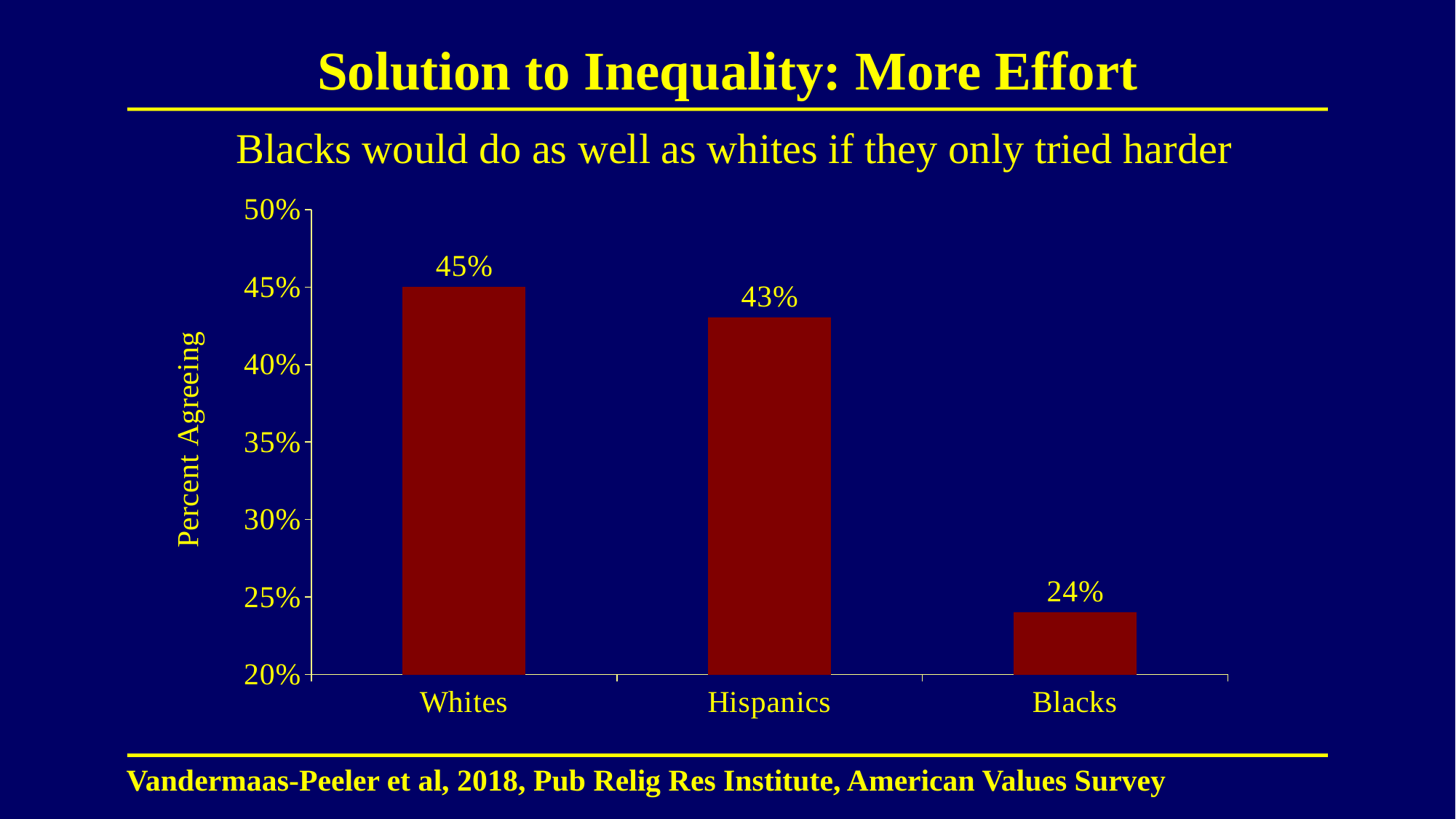
What is the difference in percent agreeing between Whites and Blacks? 21% What percent of Whites agree that Blacks would do as well as whites if they only tried harder? 45% What is the label on the vertical axis? Percent Agreeing What is the value shown for Hispanics? 43% Which group has the highest percent agreeing? Whites How many groups are shown on the x axis? 3 What is the difference in percent agreeing between Hispanics and Blacks? 19% What is the value shown for Blacks? 24% What kind of chart is shown on the slide? Bar chart Which group has the lowest percent agreeing? Blacks Which group has a larger percent agreeing, Hispanics or Blacks? Hispanics Is the value for Blacks greater or less than 30%? less